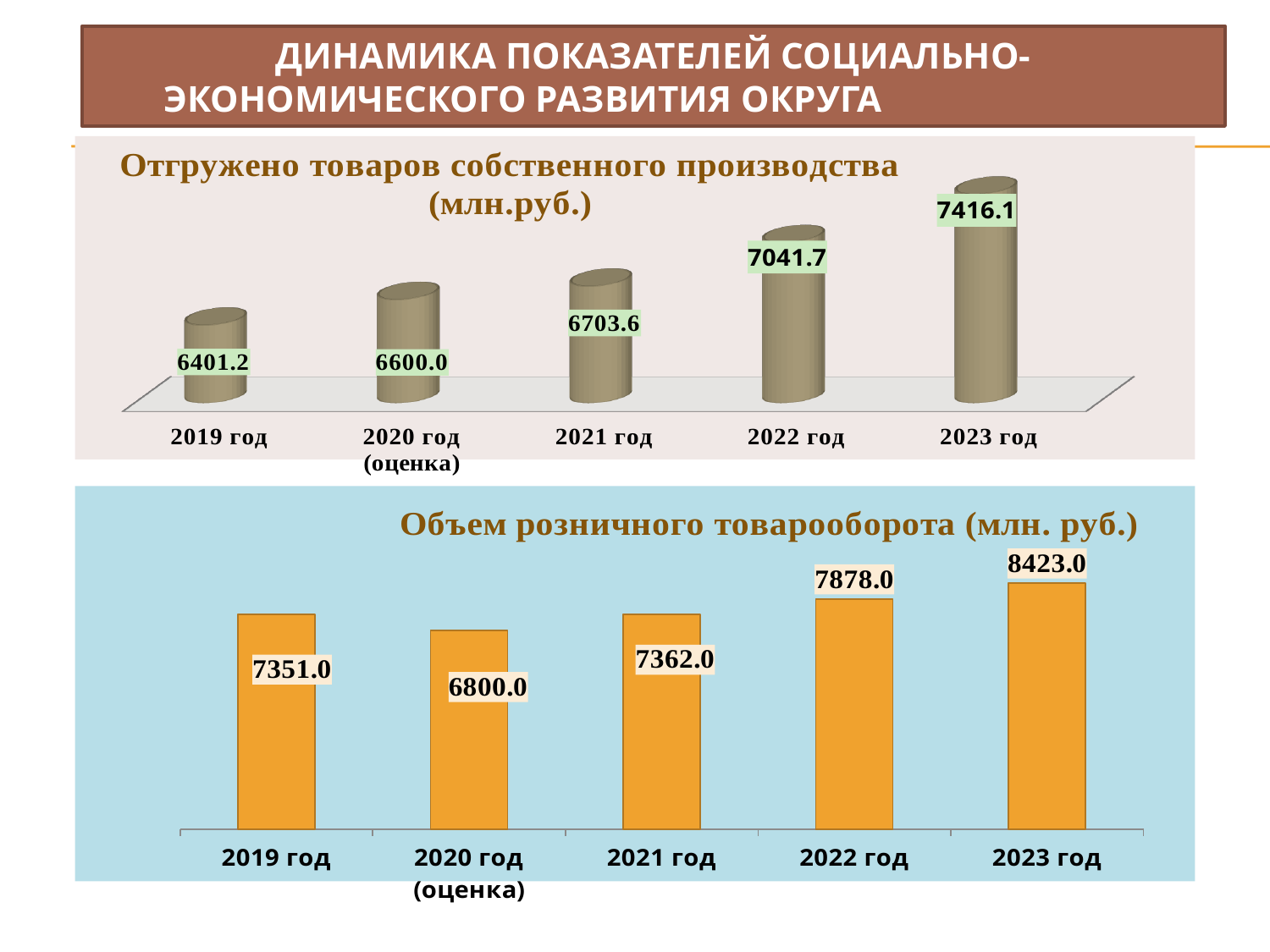
What type of chart is the bottom chart 'Объем розничного товарооборота'? Bar chart In the top chart 'Отгружено товаров собственного производства', what is the value for 2020 год (оценка)? 6600.0 In the bottom chart 'Объем розничного товарооборота', which is larger: the value for 2022 год or 2021 год? 2022 год In the bottom chart 'Объем розничного товарооборота', what is the value for 2022 год? 7878.0 In the top chart 'Отгружено товаров собственного производства', which year has the highest value? 2023 год In the bottom chart 'Объем розничного товарооборота', which year has the lowest value? 2020 год (оценка) In the top chart 'Отгружено товаров собственного производства', what is the value for 2021 год? 6703.6 In the top chart 'Отгружено товаров собственного производства', do the values rise or fall from 2019 год to 2023 год? Rise In the top chart 'Отгружено товаров собственного производства', what is the difference between the 2023 год and 2019 год values? 1014.9 What unit is given in the title of the bottom chart 'Объем розничного товарооборота'? млн. руб. In the bottom chart 'Объем розничного товарооборота', what is the difference between the 2023 год and 2020 год (оценка) values? 1623.0 How many years are shown in the top chart 'Отгружено товаров собственного производства'? 5